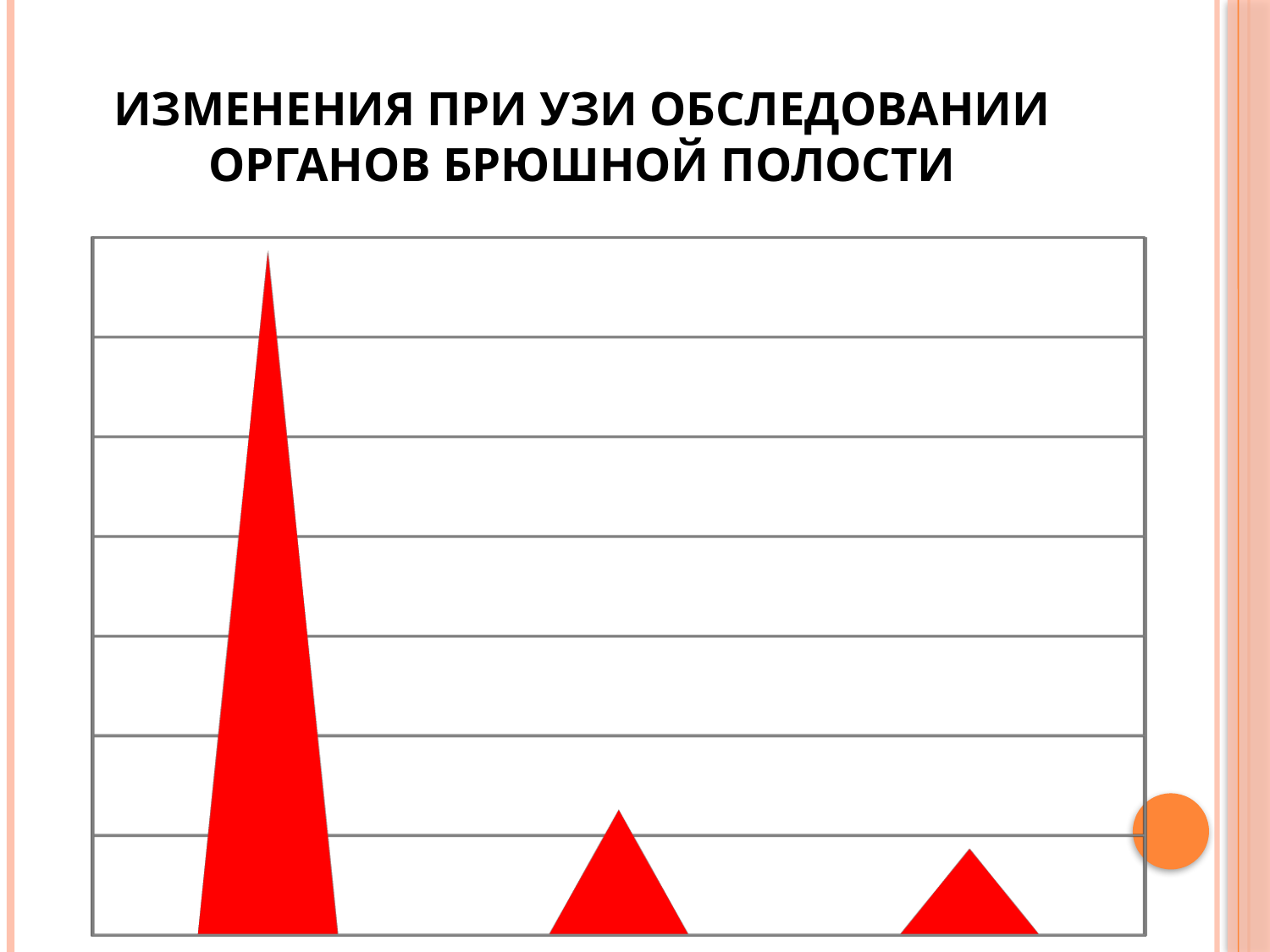
Which is taller, the leftmost bar or the middle bar? the leftmost bar What colour are the bars in the chart? red Which bar is the tallest in the chart: the leftmost, the middle, or the rightmost? the leftmost Which is taller, the middle bar or the rightmost bar? the middle bar What kind of chart is shown on the slide? bar chart Which bar is the shortest in the chart: the leftmost, the middle, or the rightmost? the rightmost Do the bar heights rise or fall from left to right across the chart? fall What is the title of the slide containing the chart? ИЗМЕНЕНИЯ ПРИ УЗИ ОБСЛЕДОВАНИИ ОРГАНОВ БРЮШНОЙ ПОЛОСТИ How many bars are plotted in the chart? 3